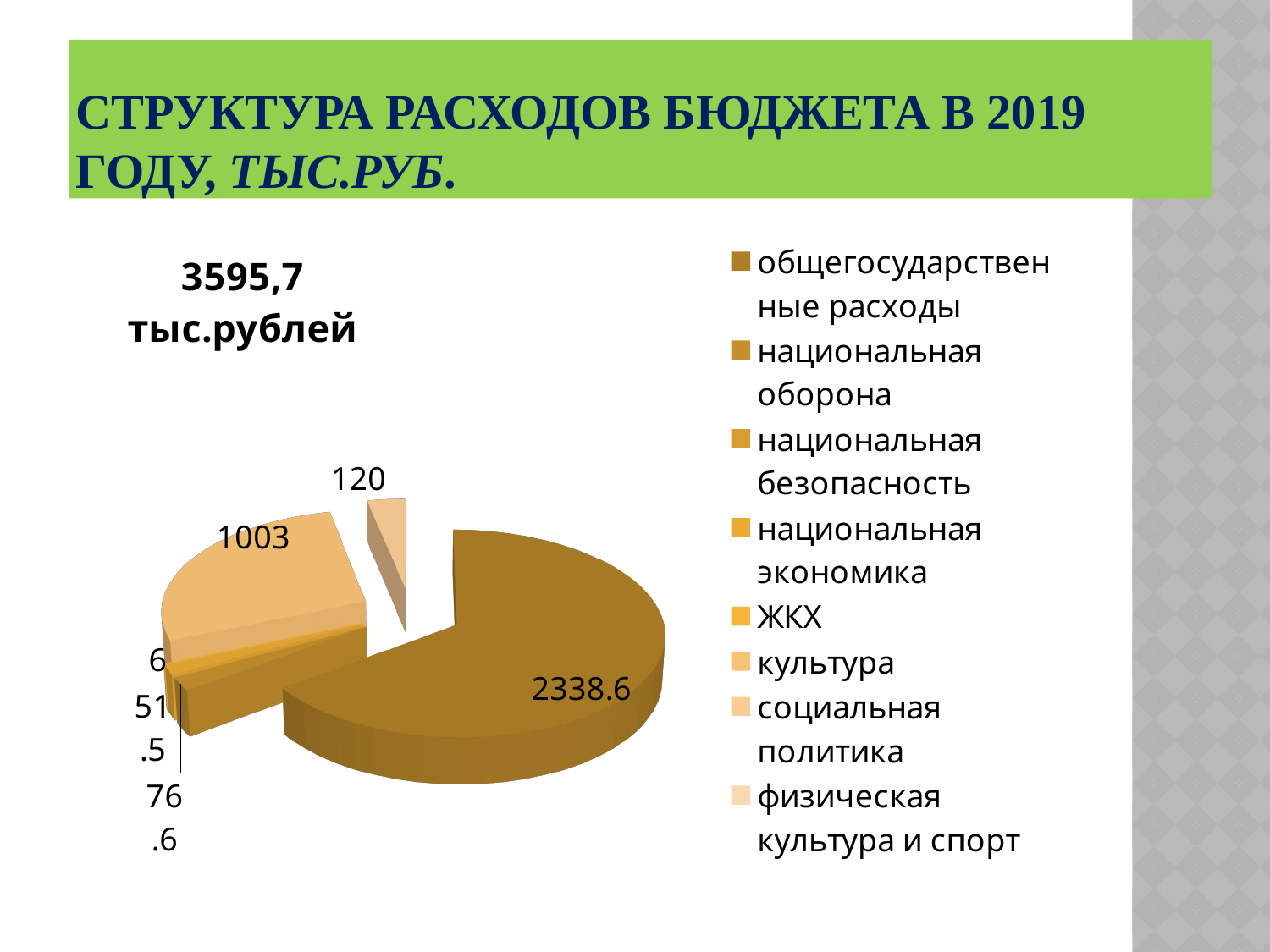
Which category has the largest slice in the pie chart? общегосударственные расходы What type of chart is shown on the slide? pie chart What is the smallest value printed as a data label on the pie chart? 6 What value is shown for the социальная политика slice? 120 What total amount is shown as the title above the pie chart? 3595,7 тыс.рублей What is the first entry in the pie chart's legend? общегосударственные расходы How many categories does the legend of the pie chart list? 8 Which is larger: the slice labelled 2338.6 or the slice labelled 1003? 2338.6 What is the difference between the slice labelled 1003 and the slice labelled 120? 883 What is the difference between the slice labelled 2338.6 and the slice labelled 1003? 1335.6 What is the value of the largest slice of the pie chart? 2338.6